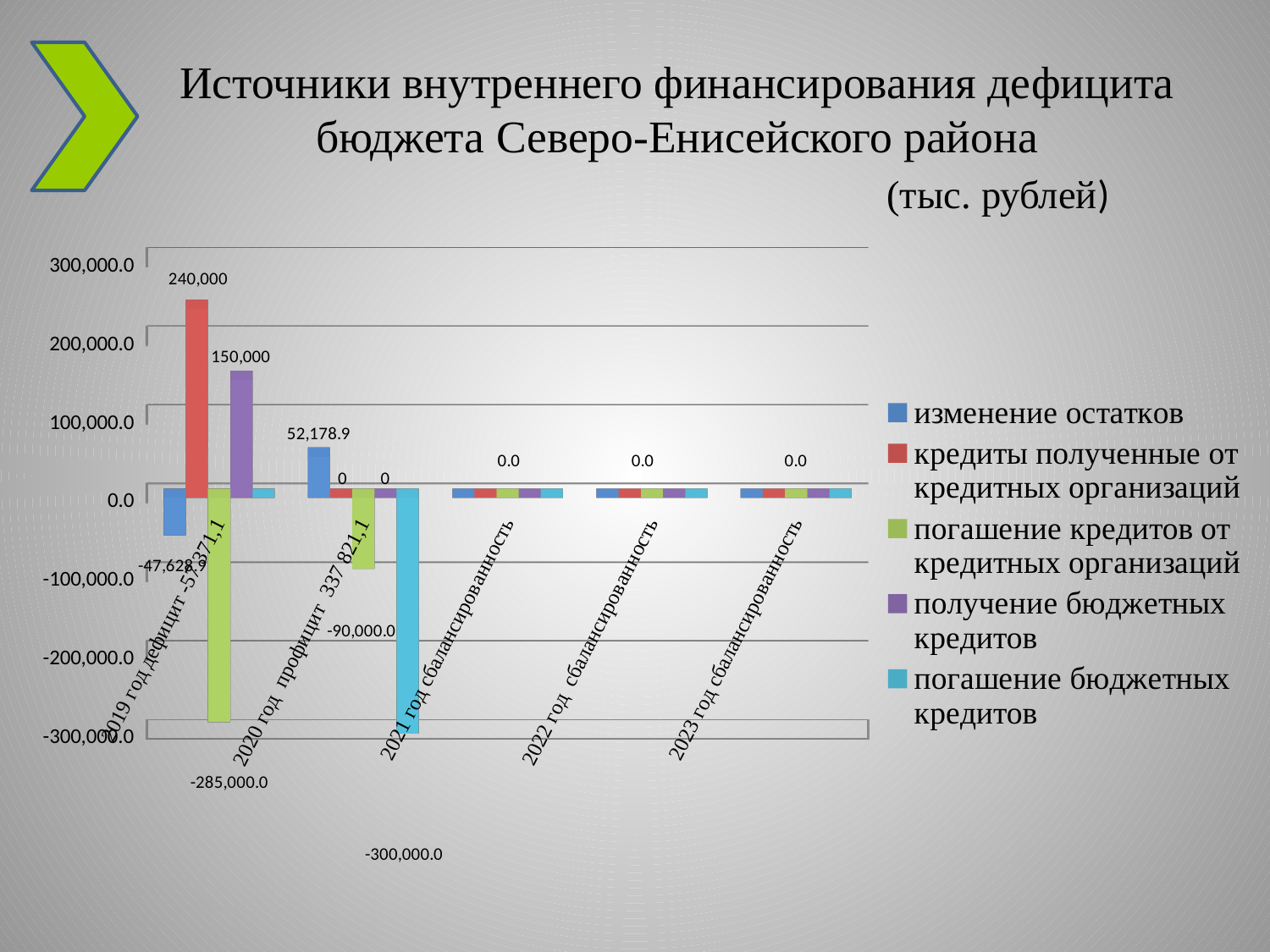
Which series has the highest value in 2019? кредиты полученные от кредитных организаций What is the value of 'кредиты полученные от кредитных организаций' for 2019? 240,000 What is the value of 'погашение бюджетных кредитов' for 2020? -300,000.0 What kind of chart is shown on the slide? bar chart What is the value of 'погашение кредитов от кредитных организаций' for 2019? -285,000.0 What is the difference between 'кредиты полученные от кредитных организаций' and 'получение бюджетных кредитов' in 2019? 90,000 What is the value of 'изменение остатков' for 2020? 52,178.9 How many year categories are shown along the x axis? 5 Is the value of 'изменение остатков' for 2019 greater or less than -100,000.0? greater What is the value of 'получение бюджетных кредитов' for 2019? 150,000 How many series does the legend list? 5 What is the value of 'погашение кредитов от кредитных организаций' for 2020? -90,000.0